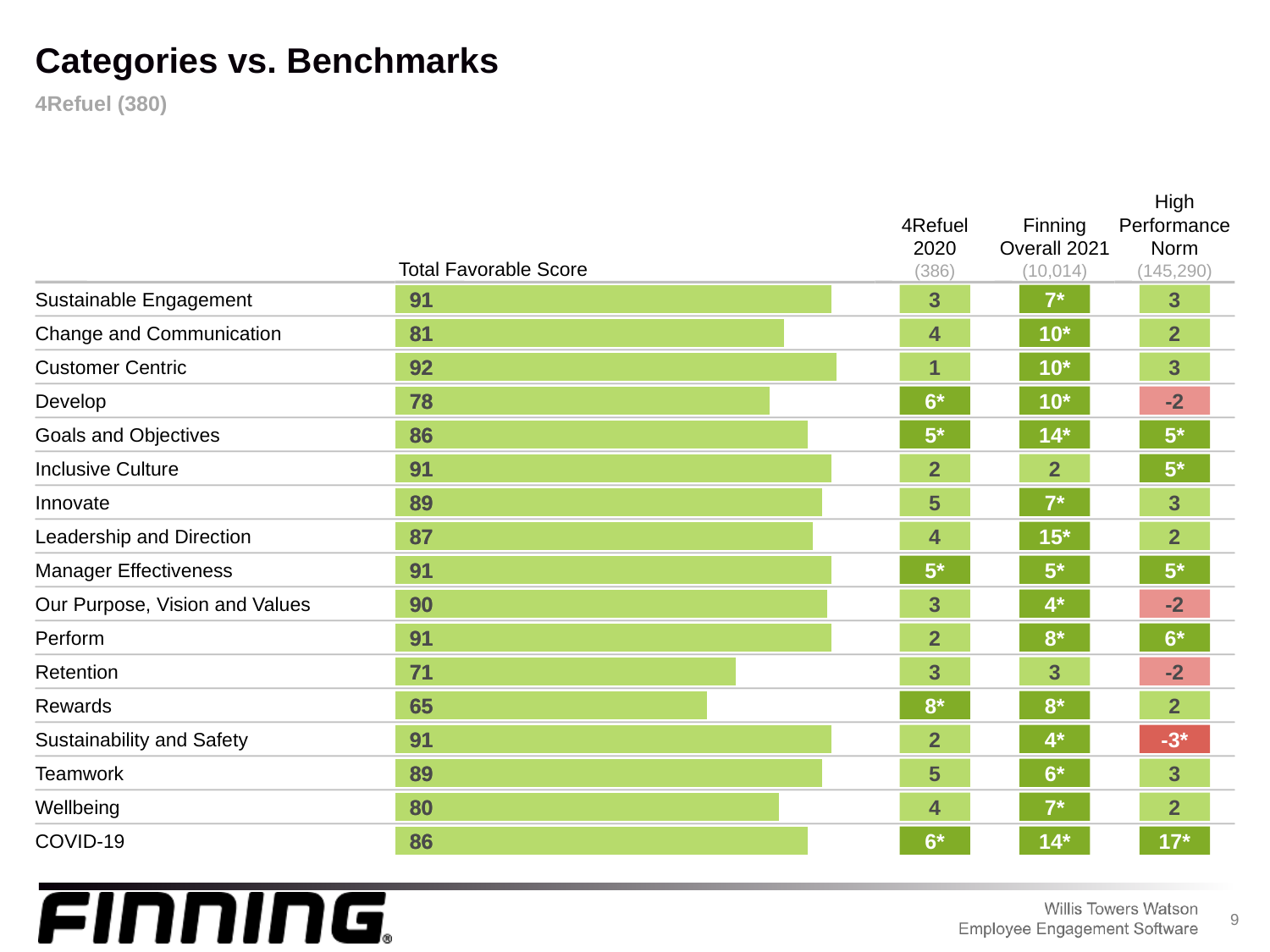
What is the title of the slide? Categories vs. Benchmarks Which has a higher Total Favorable Score, Develop or Wellbeing? Wellbeing What is the Total Favorable Score for Customer Centric? 92 What is the Total Favorable Score for Rewards? 65 Which category has the lowest Total Favorable Score? Rewards What kind of chart is used to show the Total Favorable Score? Bar chart What is the Total Favorable Score for Retention? 71 How many categories are shown in the Total Favorable Score chart? 17 What is the value shown for COVID-19 in the High Performance Norm column? 17* Which category has the highest Total Favorable Score? Customer Centric What is the difference between the Total Favorable Scores for Customer Centric and Rewards? 27 What is the difference between the Total Favorable Scores for Sustainable Engagement and Change and Communication? 10